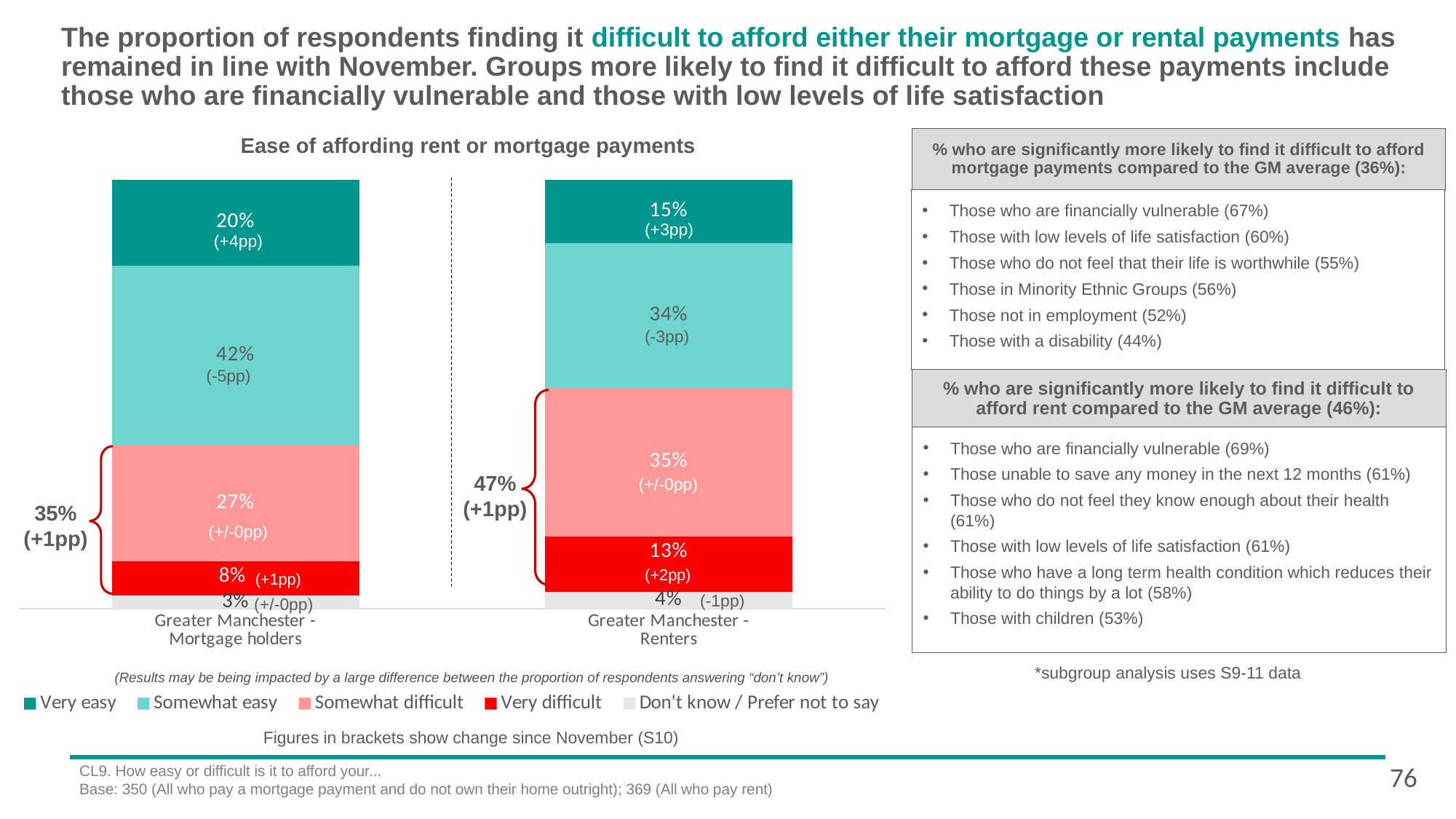
What is the title of the chart? Ease of affording rent or mortgage payments What is the combined share of mortgage holders finding it somewhat or very difficult to afford their payments, as shown by the bracket? 35% Which group has a larger 'Very difficult' share, mortgage holders or renters? Renters How many categories (bars) are plotted in the chart? 2 What is the difference between the 'Somewhat difficult' share for renters and for mortgage holders? 8 percentage points Which response category is the largest for Greater Manchester mortgage holders? Somewhat easy What percentage of Greater Manchester renters answered 'Very easy'? 15% How many series does the chart legend list? 5 Which response category is the smallest for Greater Manchester renters? Don't know / Prefer not to say What kind of chart is shown on the slide? Stacked bar chart What percentage of Greater Manchester renters find it very difficult to afford their payments? 13% What percentage of Greater Manchester mortgage holders find it somewhat easy to afford their payments? 42%